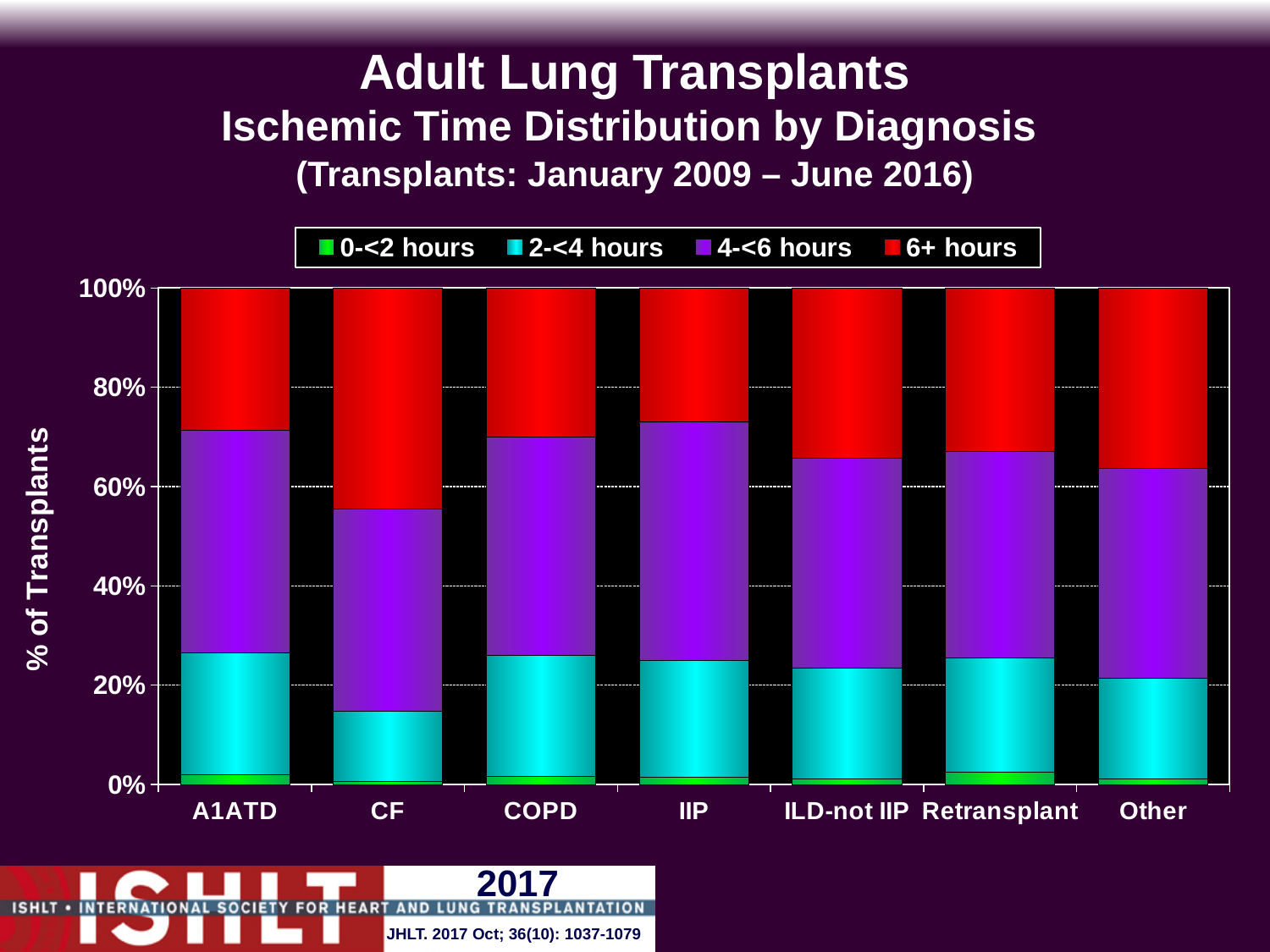
Which diagnosis has the largest share of transplants with an ischemic time of 6+ hours? CF How many series does the legend list? 4 Is the 2-<4 hours share larger for A1ATD or for CF? A1ATD How many diagnosis categories are shown along the x axis? 7 What kind of chart is shown on the slide? Stacked bar chart For IIP, is the cumulative share of transplants with an ischemic time under 6 hours (top of the 4-<6 hours segment) greater or less than 70%? greater What is the label on the y axis of the chart? % of Transplants For CF, is the cumulative share of transplants with an ischemic time under 6 hours (top of the 4-<6 hours segment) greater or less than 60%? less Is the 6+ hours share larger for CF or for IIP? CF Which diagnosis has the smallest share of transplants with an ischemic time of 2-<4 hours? CF Which diagnosis has the smallest share of transplants with an ischemic time of 6+ hours? IIP What is the total of each stacked bar in the chart? 100%